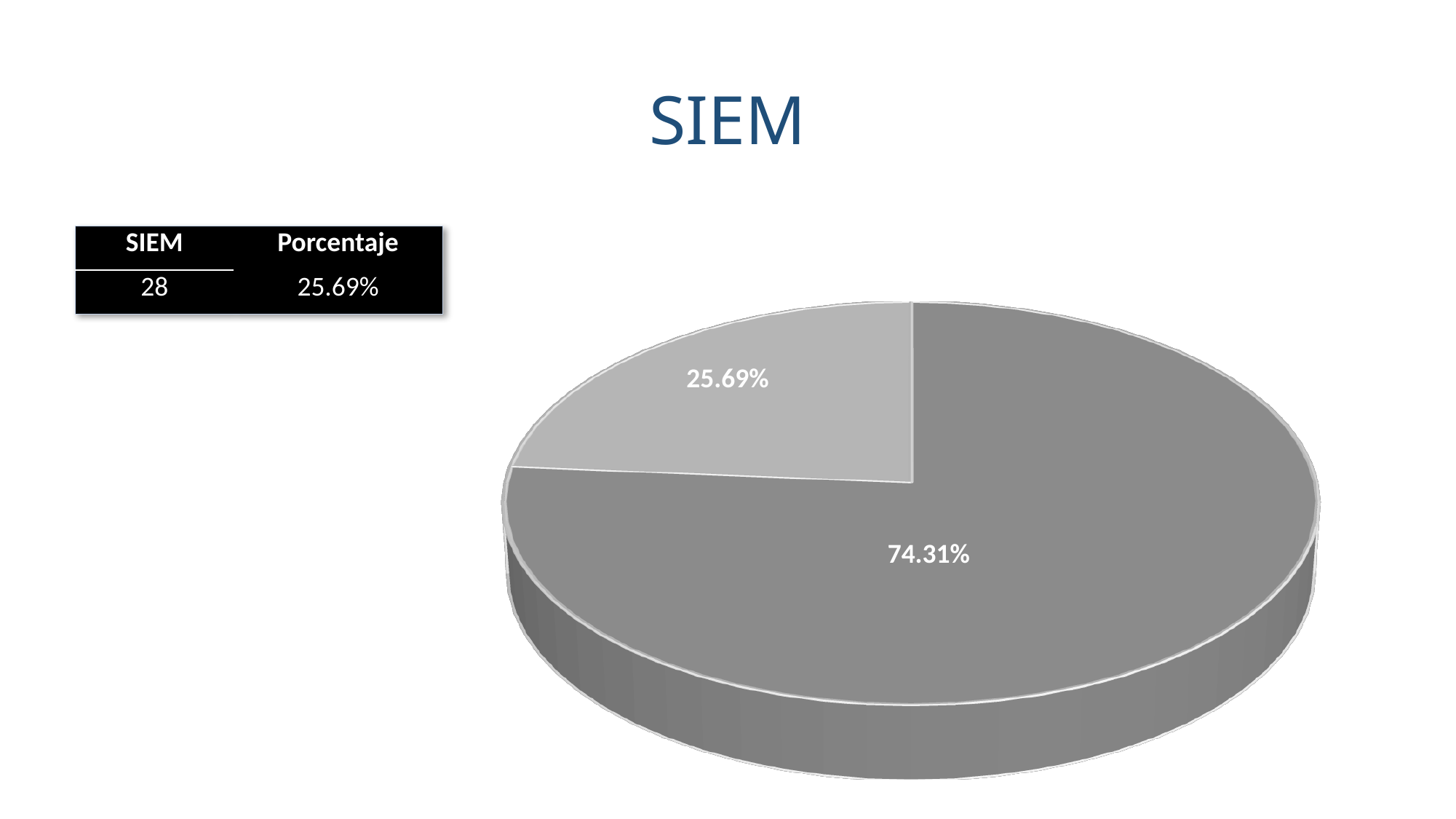
What do the two slice percentages in the pie chart add up to? 100% What is the value of the smallest slice in the pie chart? 25.69% How many slices does the pie chart have? 2 What share of the pie does the lighter grey slice represent? 25.69% What is the title of the slide containing the pie chart? SIEM What percentage is shown on the lighter grey slice of the pie chart? 25.69% What count is listed under SIEM in the table next to the pie chart? 28 What kind of chart is shown on the slide? pie chart What percentage is shown on the darker grey slice of the pie chart? 74.31% What is the value of the largest slice in the pie chart? 74.31% Which slice is larger, the lighter grey slice or the darker grey slice? the darker grey slice What is the difference between the two slice percentages in the pie chart? 48.62%